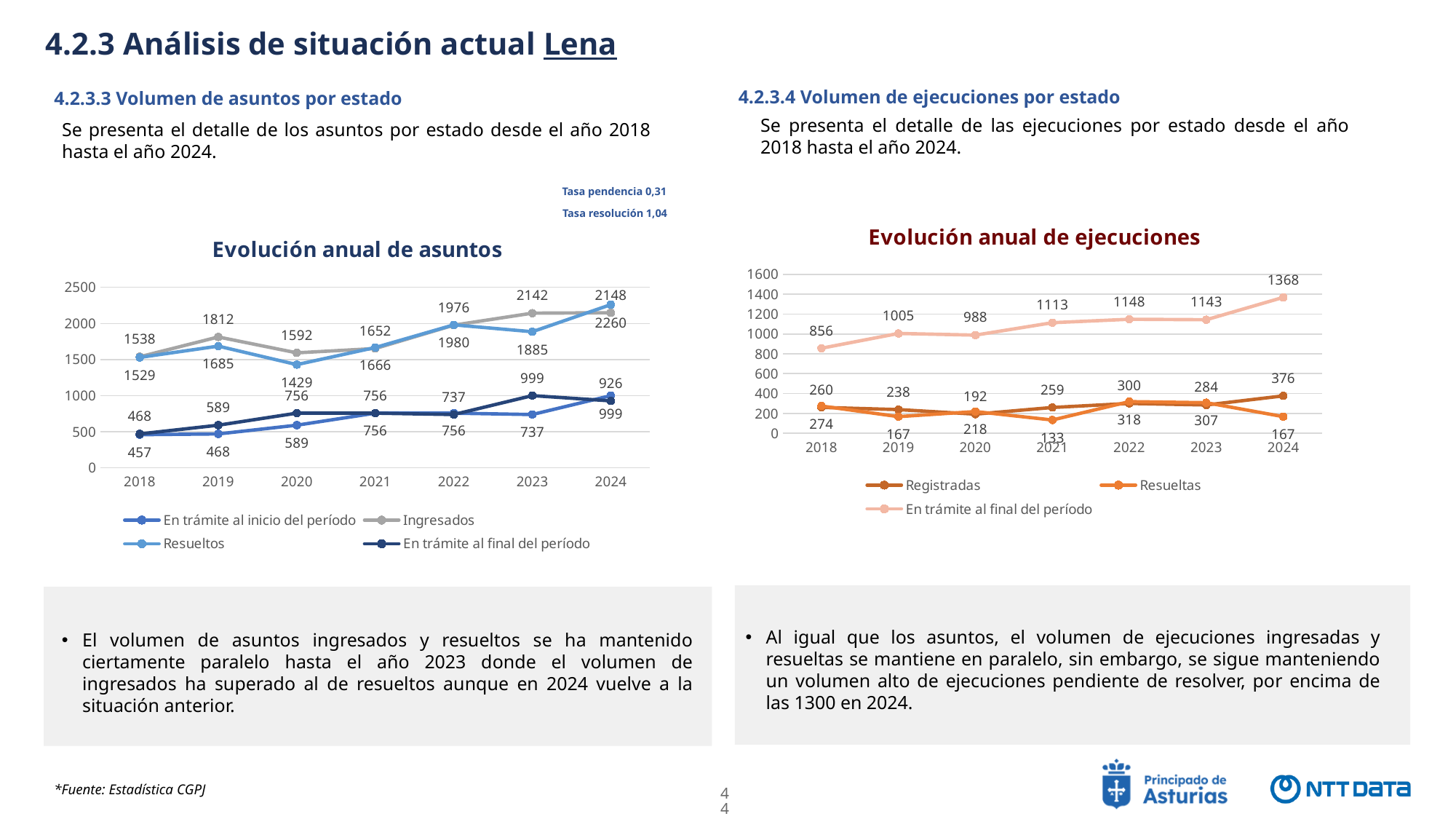
How many years are plotted on the x axis of 'Evolución anual de ejecuciones'? 7 How many series does the legend of 'Evolución anual de ejecuciones' list? 3 In 'Evolución anual de asuntos', what is the value of 'Ingresados' in 2023? 2142 What type of chart is 'Evolución anual de asuntos'? Line chart In 'Evolución anual de asuntos', which is larger in 2023, 'Ingresados' or 'Resueltos'? Ingresados In 'Evolución anual de ejecuciones', does 'En trámite al final del período' generally rise or fall from 2018 to 2024? Rise In 'Evolución anual de ejecuciones', in which year is 'En trámite al final del período' lowest? 2018 How many series does the legend of 'Evolución anual de asuntos' list? 4 In 'Evolución anual de asuntos', is the value of 'Ingresados' in 2019 greater or less than 1500? greater In 'Evolución anual de ejecuciones', what is the difference between the 'En trámite al final del período' values for 2024 and 2018? 512 In 'Evolución anual de ejecuciones', what is the value of 'En trámite al final del período' in 2024? 1368 In 'Evolución anual de ejecuciones', in which year is 'En trámite al final del período' highest? 2024